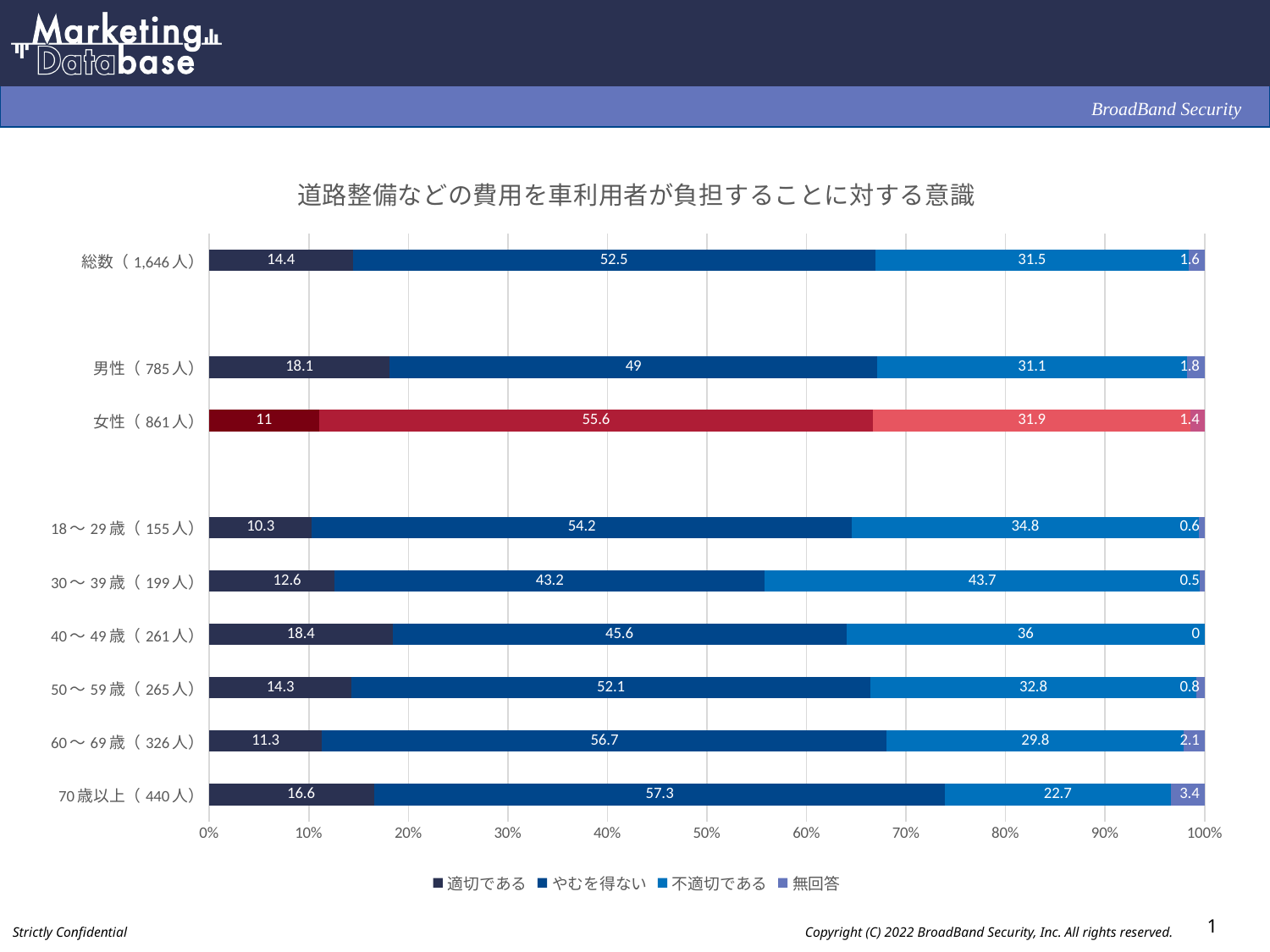
How many categories (rows) are plotted in the chart? 9 What is the value of 不適切である for 30〜39歳 (199人)? 43.7 What is the title of the chart? 道路整備などの費用を車利用者が負担することに対する意識 What is the value of やむを得ない for 70歳以上 (440人)? 57.3 How many series does the legend list? 4 Which category has the lowest value for 適切である? 18〜29歳 (155人) Which category has the highest value for やむを得ない? 70歳以上 (440人) What is the value of 無回答 for 40〜49歳 (261人)? 0 What is the difference between the 不適切である values for 男性 (785人) and 女性 (861人)? 0.8 What type of chart is shown on the slide? stacked bar chart What is the value of 適切である for 男性 (785人)? 18.1 Which is larger, the 適切である value for 総数 (1,646人) or for 50〜59歳 (265人)? 総数 (1,646人)